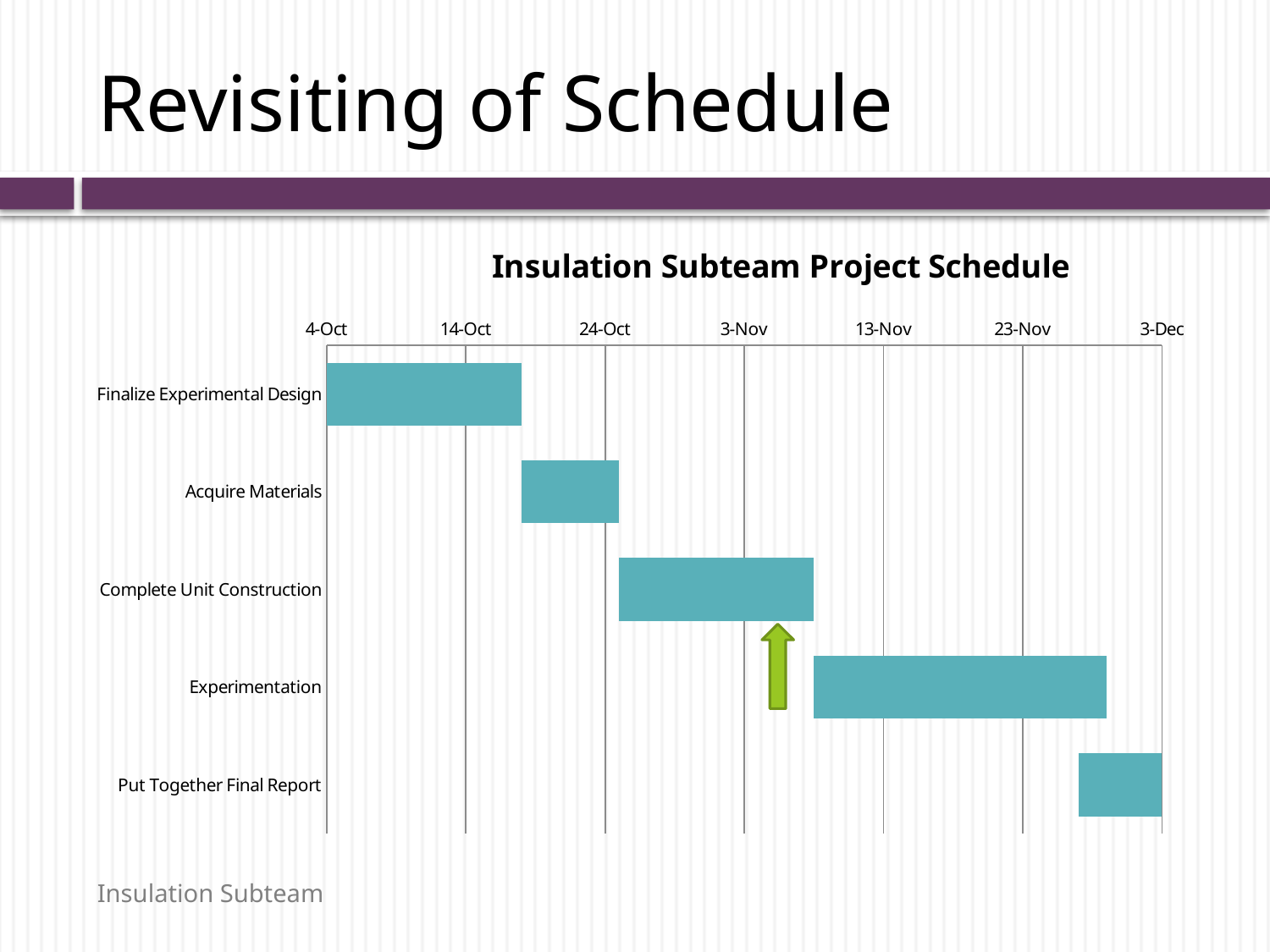
How many tasks are listed on the vertical axis of the chart? 5 Does the Finalize Experimental Design task end before or after 24-Oct? before Which task has a longer bar, Complete Unit Construction or Acquire Materials? Complete Unit Construction What kind of chart is shown on the slide? Bar chart (Gantt chart) Does the Complete Unit Construction task end before or after 13-Nov? before Which task is scheduled first in the chart? Finalize Experimental Design Does the Experimentation task start before or after 3-Nov? after How many date labels are shown along the horizontal axis? 7 What is the title of the chart? Insulation Subteam Project Schedule Which task has the longest bar in the schedule? Experimentation